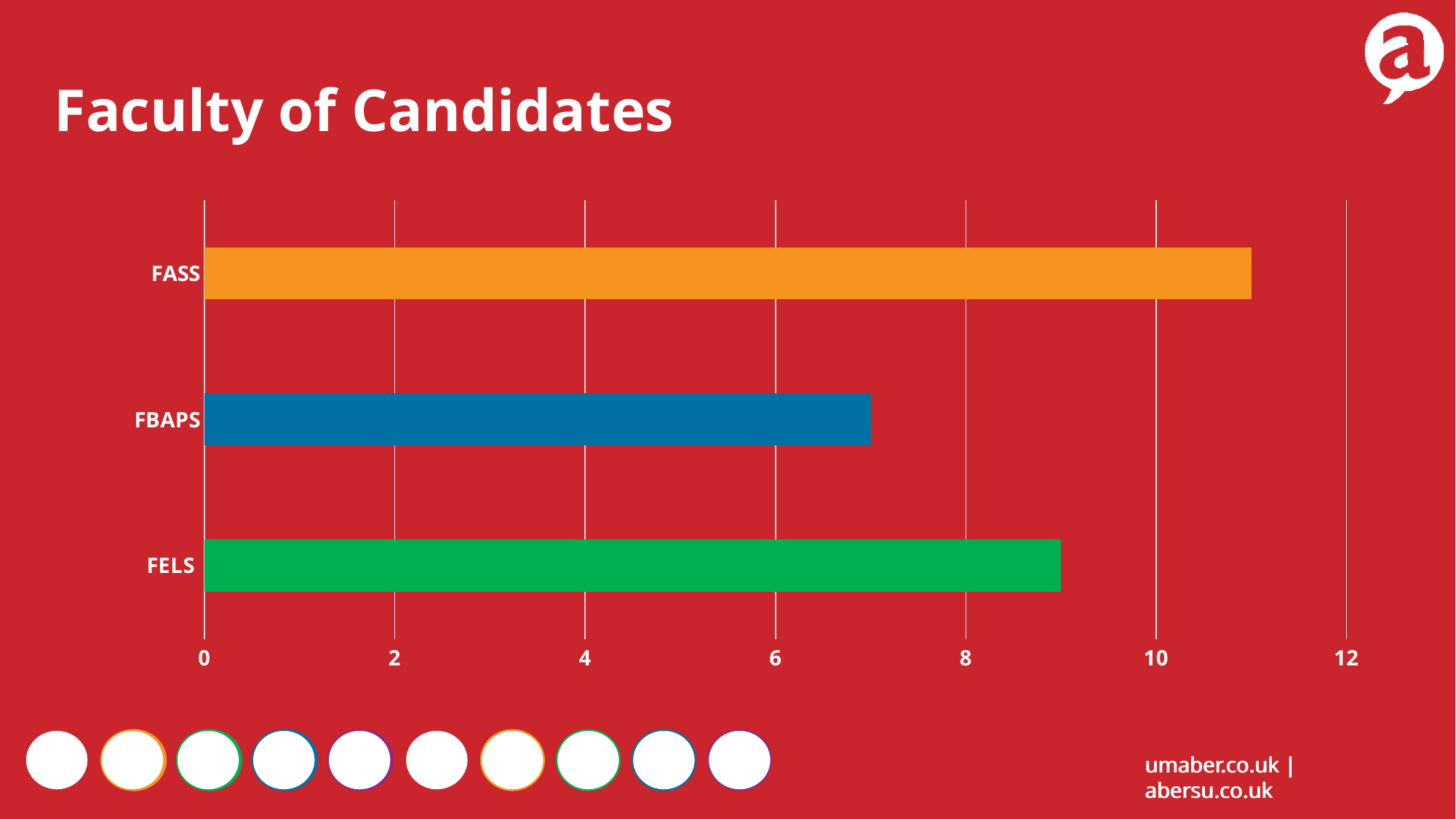
Is the value for FASS greater or less than 10? greater Is the value for FBAPS greater or less than 8? less Which has more candidates, FELS or FBAPS? FELS Is the value for FELS greater or less than 8? greater Which faculty has the lowest number of candidates? FBAPS Which faculty has the highest number of candidates? FASS How many faculties are shown in the chart? 3 What kind of chart is shown on the slide? bar chart What is the title of the chart? Faculty of Candidates What colour is the bar for FBAPS? blue